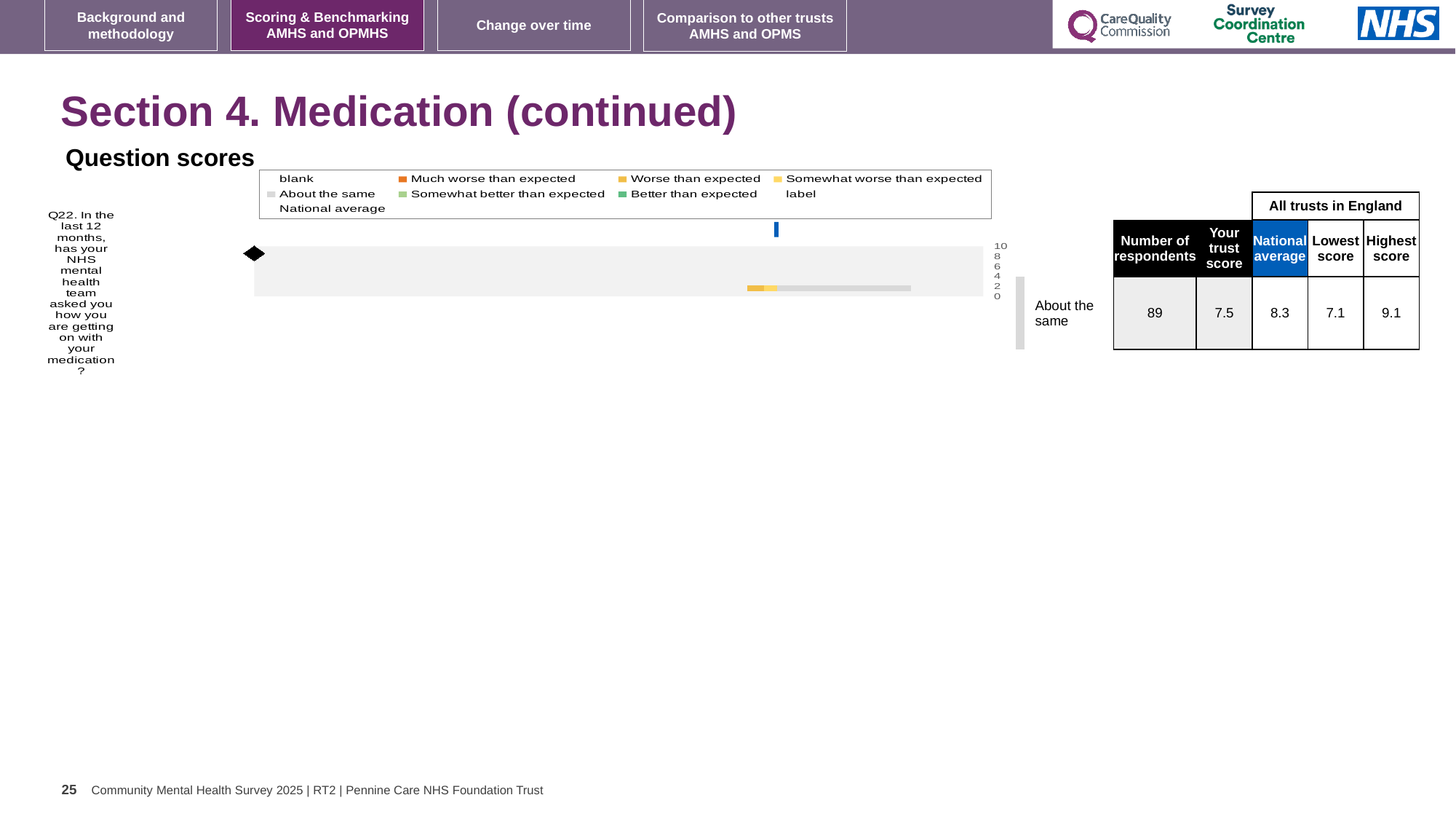
For Q22, which is larger: the trust score or the National average? National average What is the 'Your trust score' value for Q22 in the table beside the chart? 7.5 How many entries does the legend of the Question scores chart list? 9 What colour does the legend use for 'Much worse than expected'? orange What is the Lowest score across all trusts in England for Q22? 7.1 How many survey questions are plotted in the Question scores chart? 1 What kind of chart is shown under 'Question scores'? bar chart Which question number is plotted in the Question scores chart? Q22 What is the Highest score across all trusts in England for Q22? 9.1 What is the difference between the Highest score and the Lowest score for Q22? 2.0 How many respondents answered Q22? 89 What is the National average for Q22 in the table beside the chart? 8.3